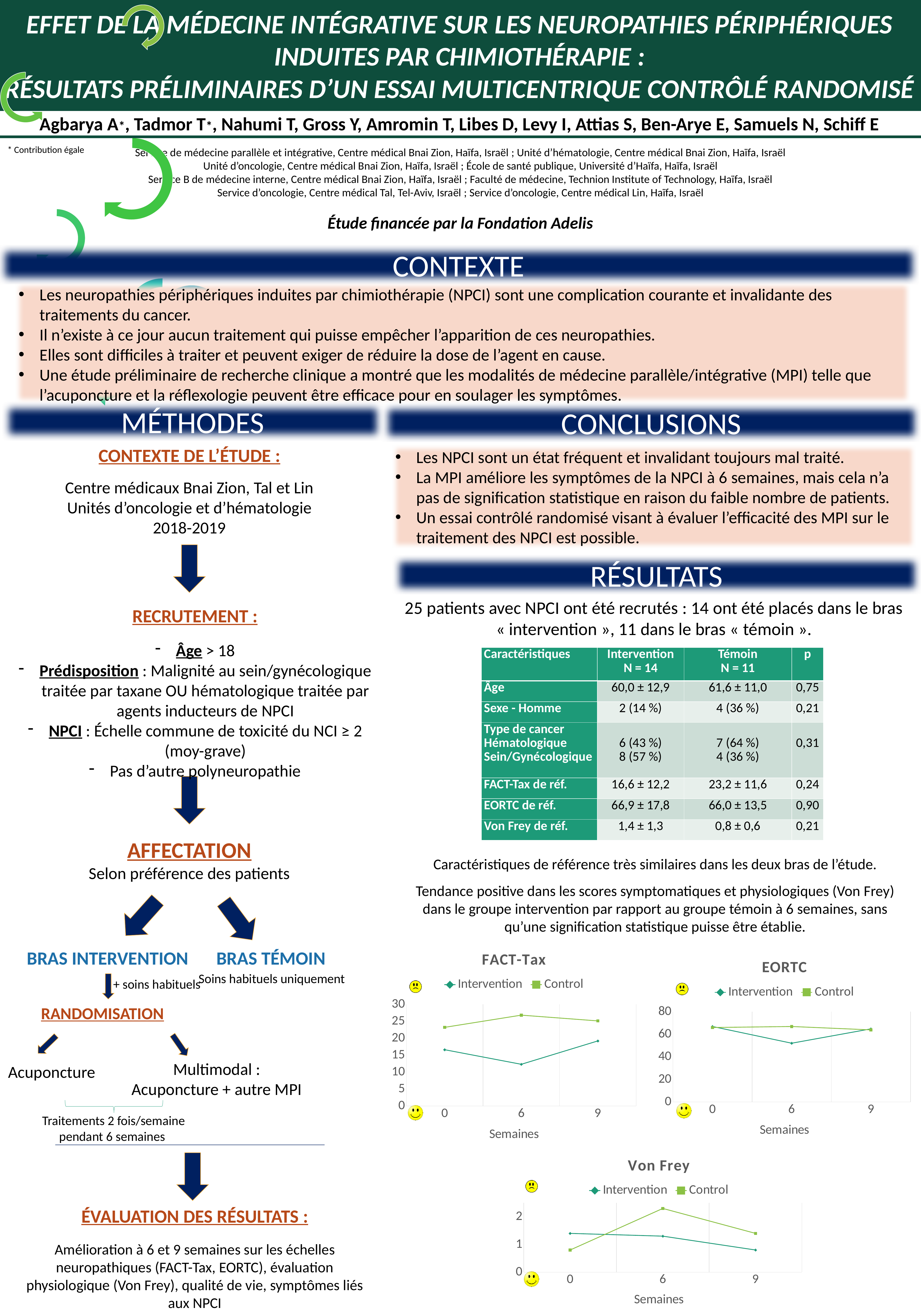
What kind of chart is the FACT-Tax chart? line chart How many time points are plotted on the x axis of the Von Frey chart? 3 What is the x-axis label of the EORTC chart? Semaines In the FACT-Tax chart, is the Intervention value at week 6 greater or less than 15? less In the Von Frey chart, which series has the higher value at week 6, Intervention or Control? Control In the Von Frey chart, is the Control value at week 6 greater or less than 2? greater In the EORTC chart, is the Intervention value at week 6 greater or less than 60? less How many series does the legend of the EORTC chart list? 2 In the FACT-Tax chart, which series has the higher value at week 6, Intervention or Control? Control In the EORTC chart, which series has the higher value at week 6, Intervention or Control? Control In the Von Frey chart, does the Intervention series rise or fall from week 0 to week 9? fall